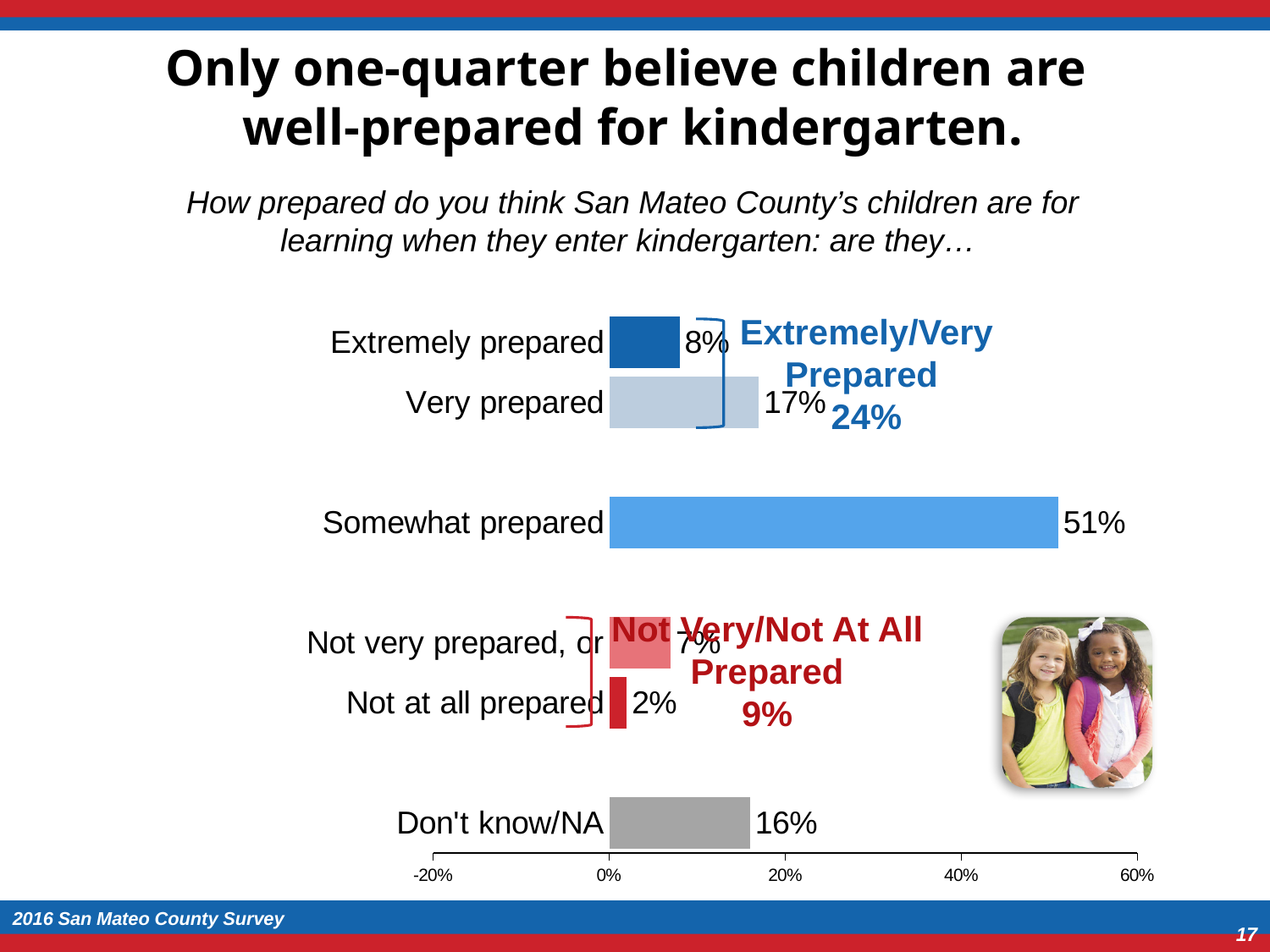
What is the value for Very prepared? 17% What is the combined percentage for Not Very/Not At All Prepared shown on the chart? 9% What is the combined percentage for Extremely/Very Prepared shown on the chart? 24% Which is larger, the value for Very prepared or the value for Don't know/NA? Very prepared Which category has the lowest value? Not at all prepared What percentage of respondents said children are somewhat prepared for kindergarten? 51% How many categories are plotted on the chart? 6 Which category has the highest value? Somewhat prepared What is the value for Don't know/NA? 16% What kind of chart is shown on the slide? Bar chart What is the value for Extremely prepared? 8% What is the difference between Somewhat prepared and Very prepared? 34 percentage points